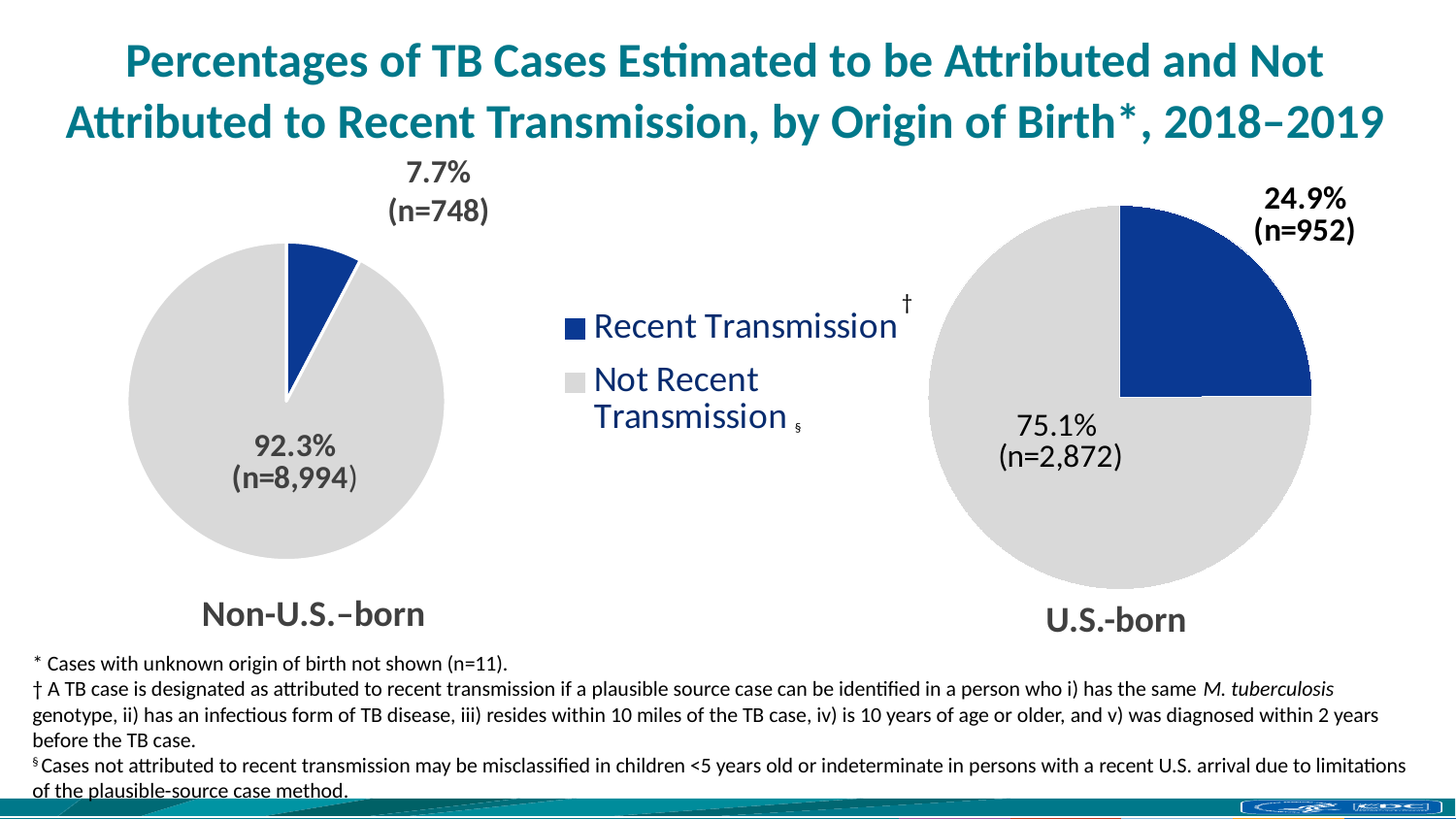
What type of charts are shown on the slide? Pie charts Which chart has the larger Recent Transmission share, Non-U.S.-born or U.S.-born? U.S.-born In the U.S.-born pie chart, how many cases are Not Recent Transmission? n=2,872 How many series does the legend list? 2 In the Non-U.S.-born pie chart, which slice is the largest? Not Recent Transmission What colour represents Recent Transmission in the pie charts? Blue In the Non-U.S.-born pie chart, how many cases are Not Recent Transmission? n=8,994 In the U.S.-born pie chart, what percentage of cases is Not Recent Transmission? 75.1% In the U.S.-born pie chart, what percentage of TB cases is attributed to Recent Transmission? 24.9% What is the difference in Recent Transmission percentage between the U.S.-born and Non-U.S.-born charts? 17.2 percentage points In the U.S.-born pie chart, which slice is the smallest? Recent Transmission In the Non-U.S.-born pie chart, what percentage of TB cases is attributed to Recent Transmission? 7.7%